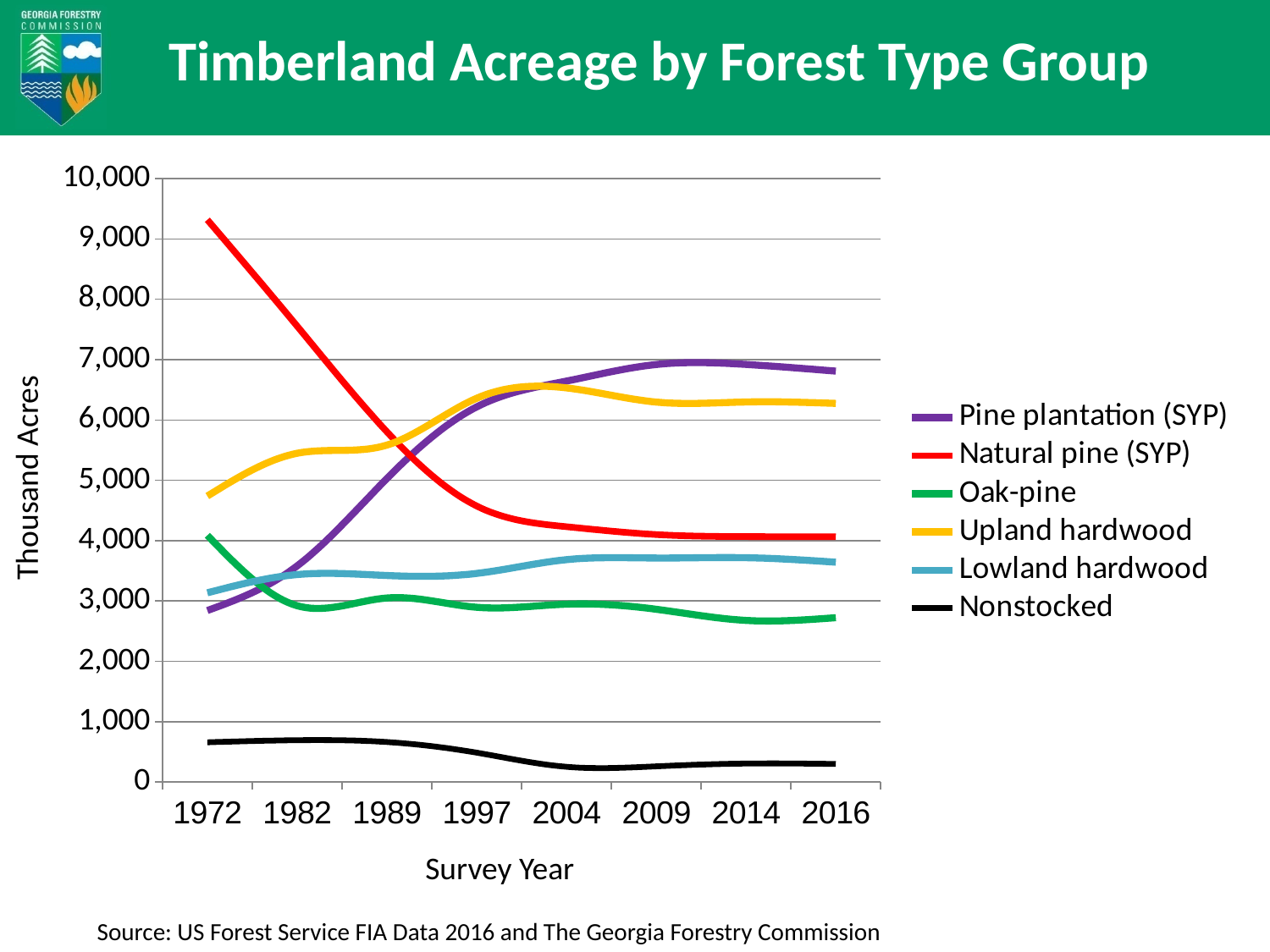
Which forest type group has the highest acreage in 1972? Natural pine (SYP) Is the value for Pine plantation (SYP) in 2016 greater or less than 6,000? greater How many series does the legend list? 6 Is the value for Nonstocked in 1972 greater or less than 1,000? less Does the Pine plantation (SYP) line rise or fall from 1972 to 2009? Rise How many survey years are shown on the x axis? 8 Is the value for Upland hardwood in 1972 greater or less than 5,000? less Which forest type group has the lowest acreage across all survey years? Nonstocked Which forest type group has the highest acreage in 2016? Pine plantation (SYP) What kind of chart is shown on the slide? Line chart Does the Natural pine (SYP) line rise or fall from 1972 to 2016? Fall